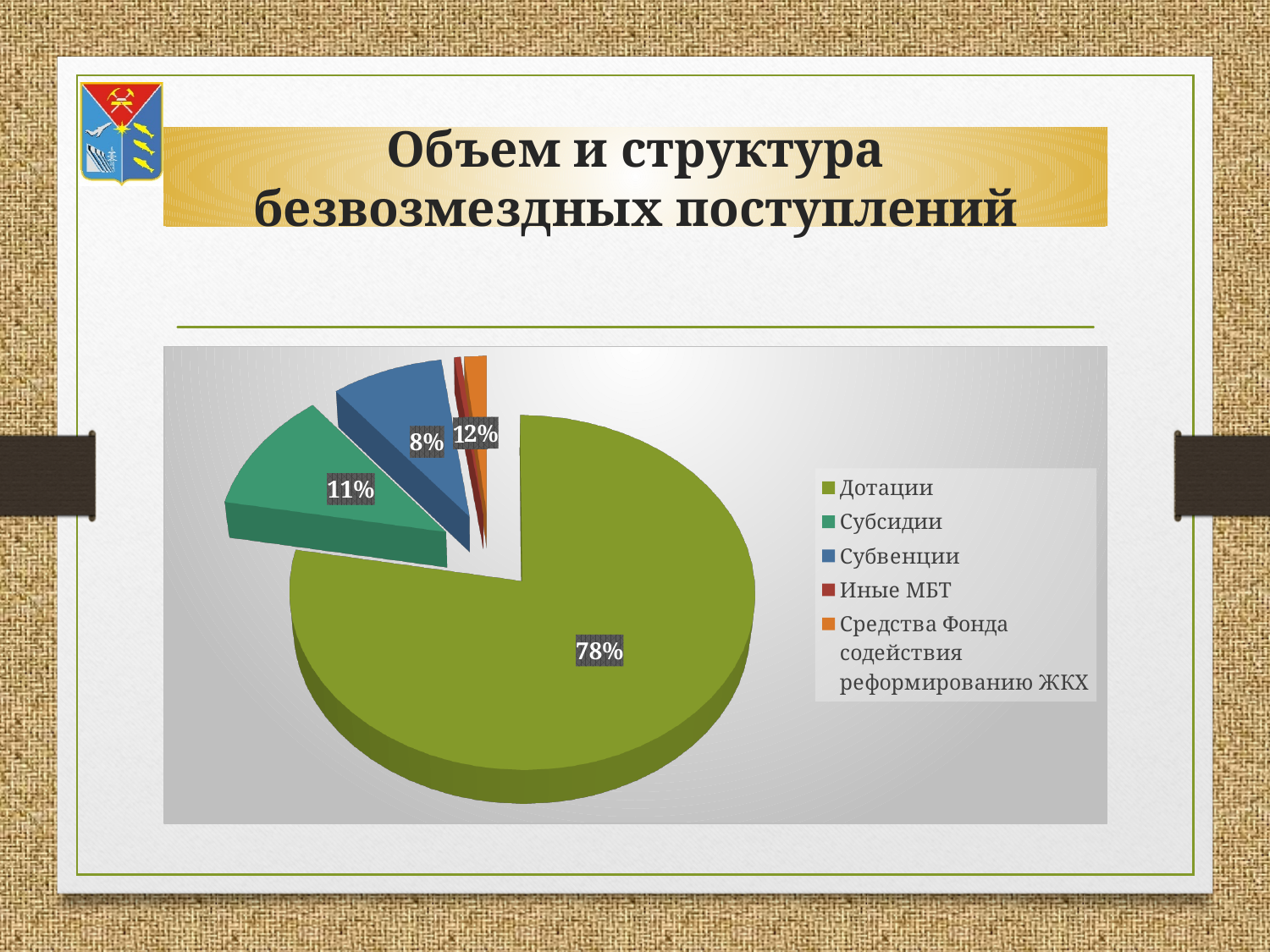
How many categories does the legend list? 5 What share of the pie does Субсидии hold? 11% What share of the pie does Дотации hold? 78% How many percentage points larger is the Дотации slice than the Субсидии slice? 67 What kind of chart is shown on the slide? Pie chart Which is larger, the slice for Субсидии or the slice for Субвенции? Субсидии What share of the pie does Субвенции hold? 8% What is the title of the slide containing the chart? Объем и структура безвозмездных поступлений How many percentage points larger is the Субсидии slice than the Субвенции slice? 3 Which legend entry is shown in blue? Субвенции Is the share for Дотации greater or less than 50%? greater Which category has the largest slice of the pie? Дотации